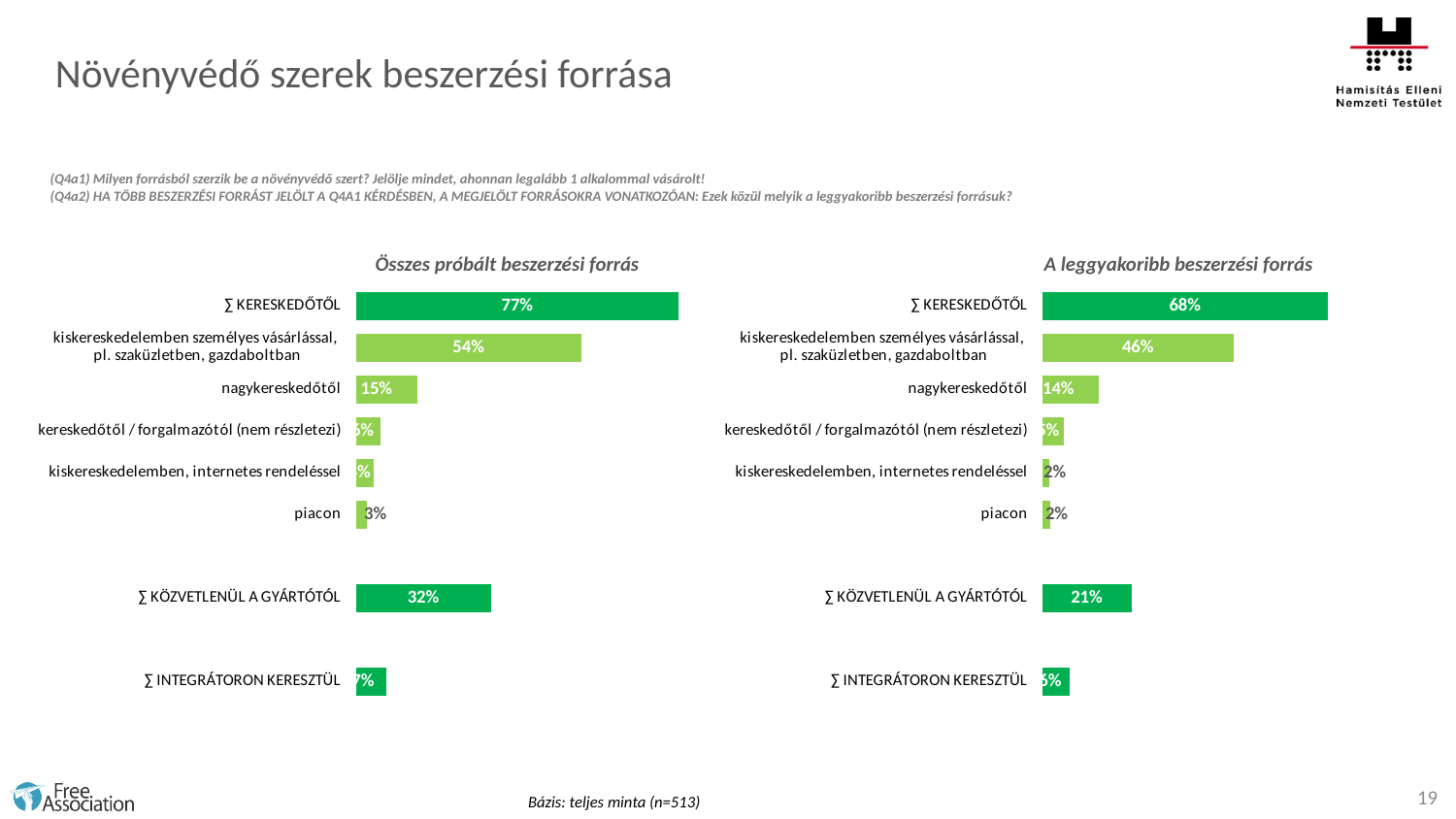
In the chart titled "Összes próbált beszerzési forrás", what is the value for ∑ KERESKEDŐTŐL? 77% In the chart titled "A leggyakoribb beszerzési forrás", what is the value for piacon? 2% In the chart titled "Összes próbált beszerzési forrás", what is the value for ∑ KÖZVETLENÜL A GYÁRTÓTÓL? 32% In the chart titled "Összes próbált beszerzési forrás", what is the value for ∑ INTEGRÁTORON KERESZTÜL? 7% In the chart titled "A leggyakoribb beszerzési forrás", what is the difference between ∑ KERESKEDŐTŐL and kiskereskedelemben személyes vásárlással, pl. szaküzletben, gazdaboltban? 22 percentage points In the chart titled "A leggyakoribb beszerzési forrás", what is the value for ∑ KÖZVETLENÜL A GYÁRTÓTÓL? 21% In the chart titled "Összes próbált beszerzési forrás", what is the difference between ∑ KERESKEDŐTŐL and kiskereskedelemben személyes vásárlással, pl. szaküzletben, gazdaboltban? 23 percentage points In the chart titled "Összes próbált beszerzési forrás", which category has the highest value? ∑ KERESKEDŐTŐL In the chart titled "Összes próbált beszerzési forrás", which is larger: kiskereskedelemben személyes vásárlással, pl. szaküzletben, gazdaboltban or ∑ KÖZVETLENÜL A GYÁRTÓTÓL? kiskereskedelemben személyes vásárlással, pl. szaküzletben, gazdaboltban In the chart titled "A leggyakoribb beszerzési forrás", what is the value for ∑ KERESKEDŐTŐL? 68% In the chart titled "Összes próbált beszerzési forrás", what is the value for nagykereskedőtől? 15% What kind of chart is the chart titled "A leggyakoribb beszerzési forrás"? bar chart